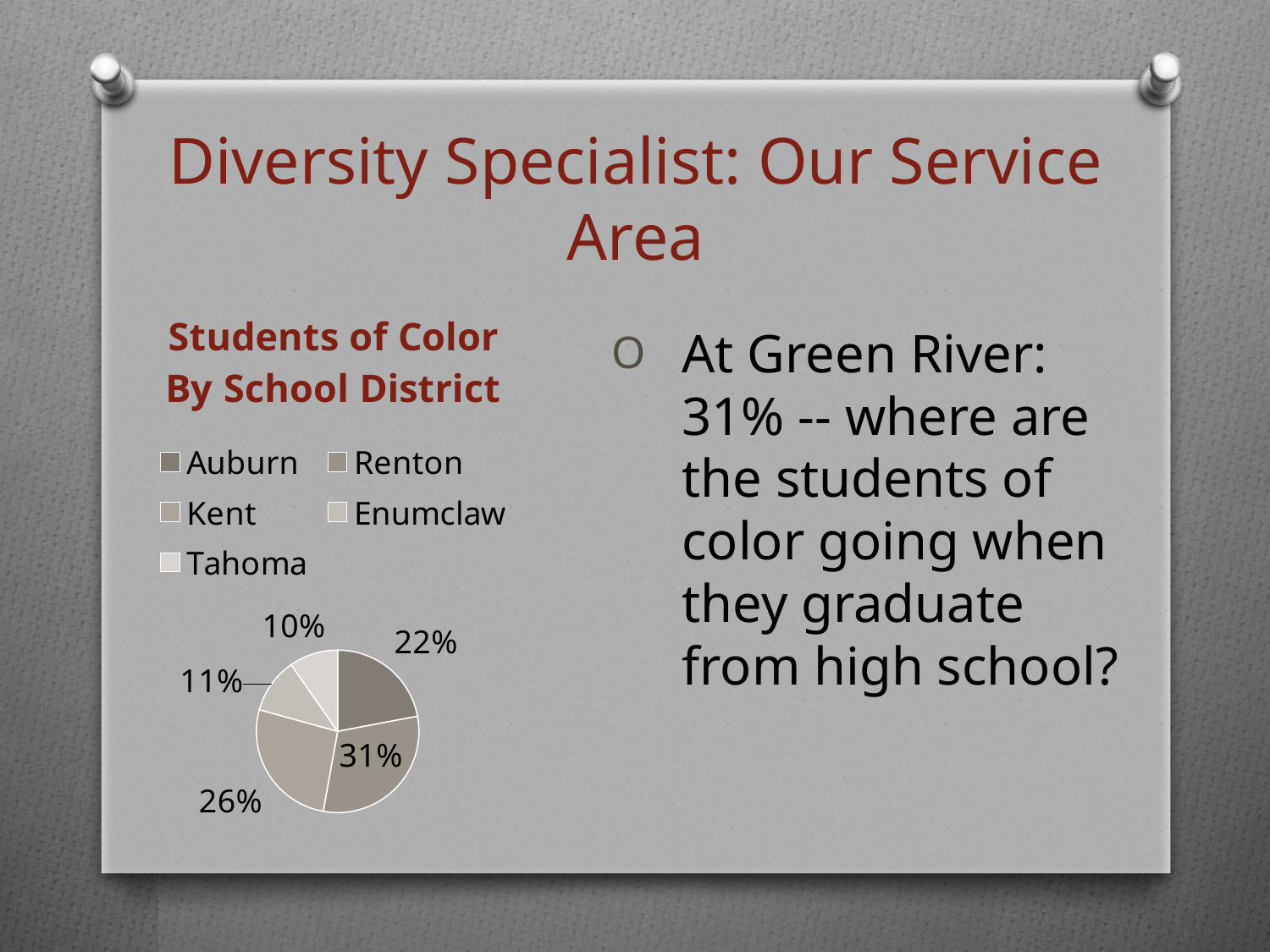
What is the difference between the 26% slice and the 11% slice in the pie chart? 15% What is the largest percentage shown on the pie chart? 31% Which district is listed first in the chart's legend? Auburn What percentage is shown for Tahoma in the pie chart? 10% What kind of chart is shown on the slide? pie chart Which is larger in the pie chart, the 26% slice or the 22% slice? the 26% slice What is the difference between the largest and smallest slices of the pie chart? 21% What percentage is shown for Auburn in the pie chart? 22% How many school districts does the chart's legend list? 5 How many slices does the pie chart have? 5 What is the title of the chart on the slide? Students of Color By School District What is the smallest percentage shown on the pie chart? 10%